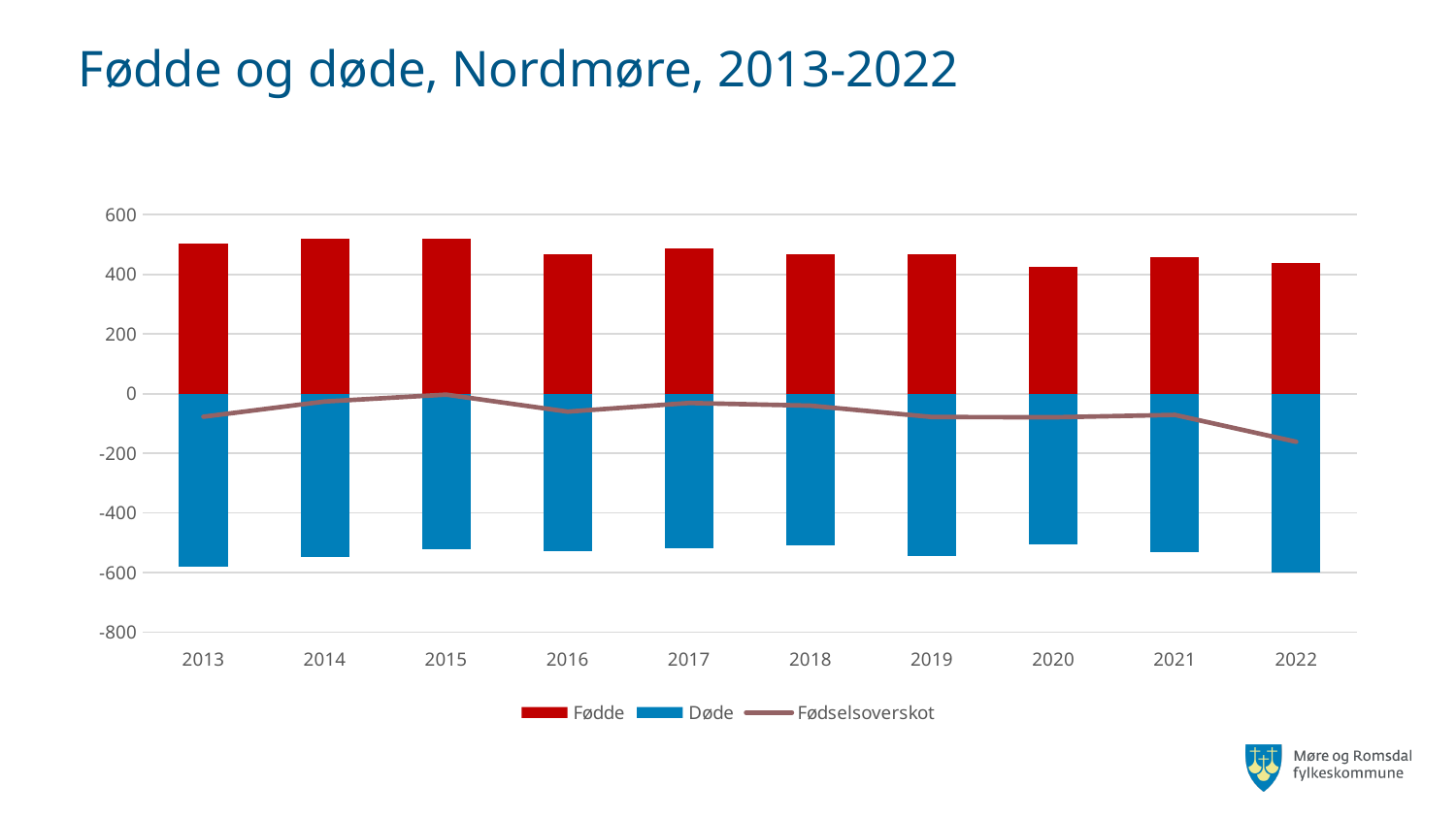
How many series does the legend list? 3 How many years are shown on the x axis? 10 Is the value for Fødde in 2020 greater or less than 600? less In which year is the Fødselsoverskot line at its highest? 2015 Is the value for Fødselsoverskot in 2022 greater or less than 0? less What is the title of the chart? Fødde og døde, Nordmøre, 2013-2022 Is the value for Fødde in 2013 greater or less than 400? greater Which series is drawn as a line rather than bars? Fødselsoverskot In which year is the Fødselsoverskot line at its lowest? 2022 Do the Fødde values generally rise or fall from 2013 to 2022? fall What kind of chart is this? Combined bar and line chart